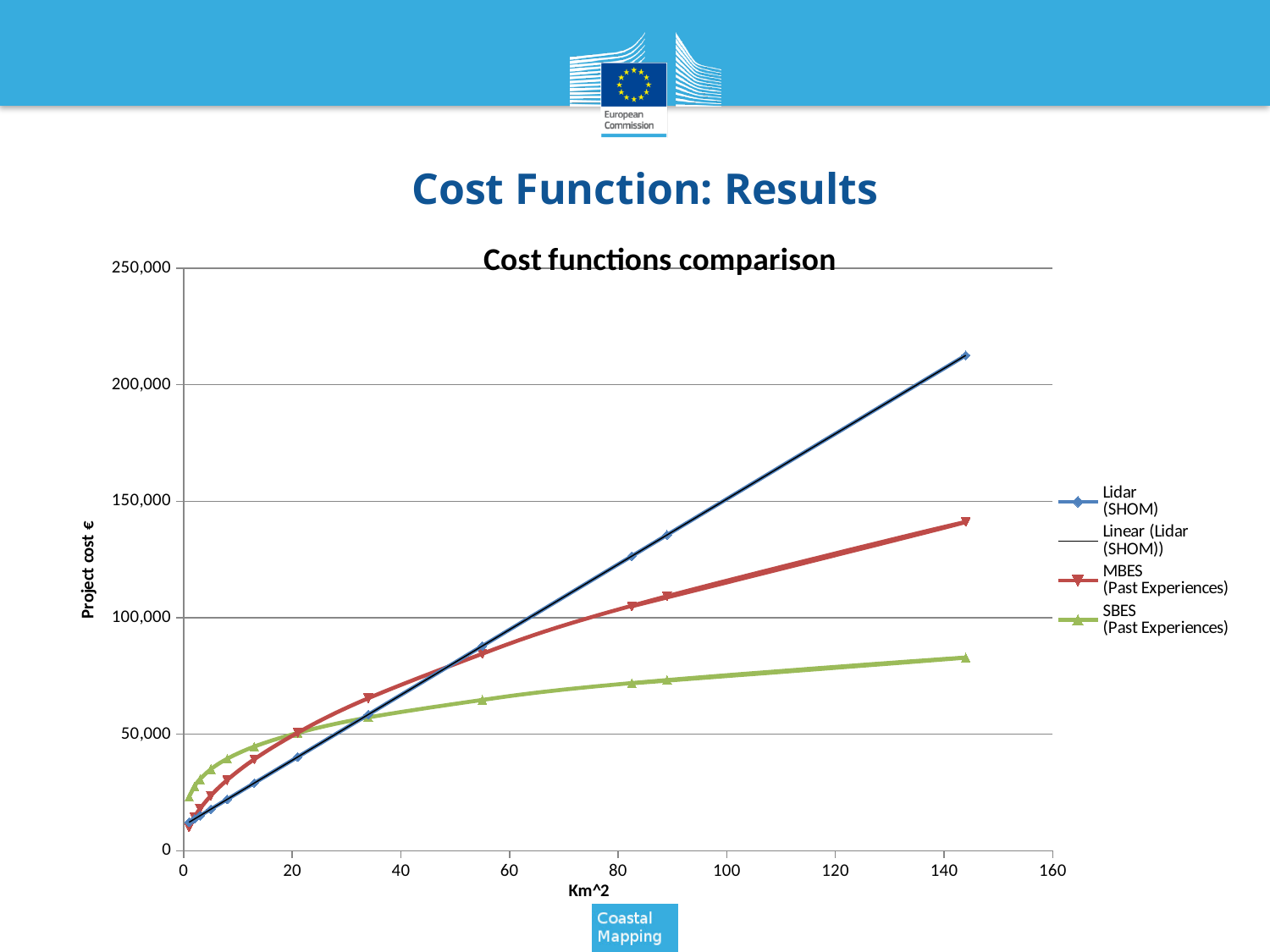
What is the title of the chart? Cost functions comparison What is the label of the x axis of the chart? Km^2 What kind of chart is shown on the slide? line chart Is the value for Lidar (SHOM) at its right-most point (around 144 Km^2) greater or less than 200,000? greater At around 144 Km^2, which series has the larger project cost, MBES (Past Experiences) or SBES (Past Experiences)? MBES (Past Experiences) How many series does the legend of the chart list? 4 Is the value for SBES (Past Experiences) at its right-most point (around 144 Km^2) greater or less than 100,000? less Which series has the lowest project cost at the right end of the chart (around 144 Km^2)? SBES (Past Experiences) Which series has the highest project cost at the right end of the chart (around 144 Km^2)? Lidar (SHOM) Is the value for SBES (Past Experiences) at its right-most point (around 144 Km^2) greater or less than 50,000? greater Does the project cost for Lidar (SHOM) rise or fall as Km^2 increases? rise